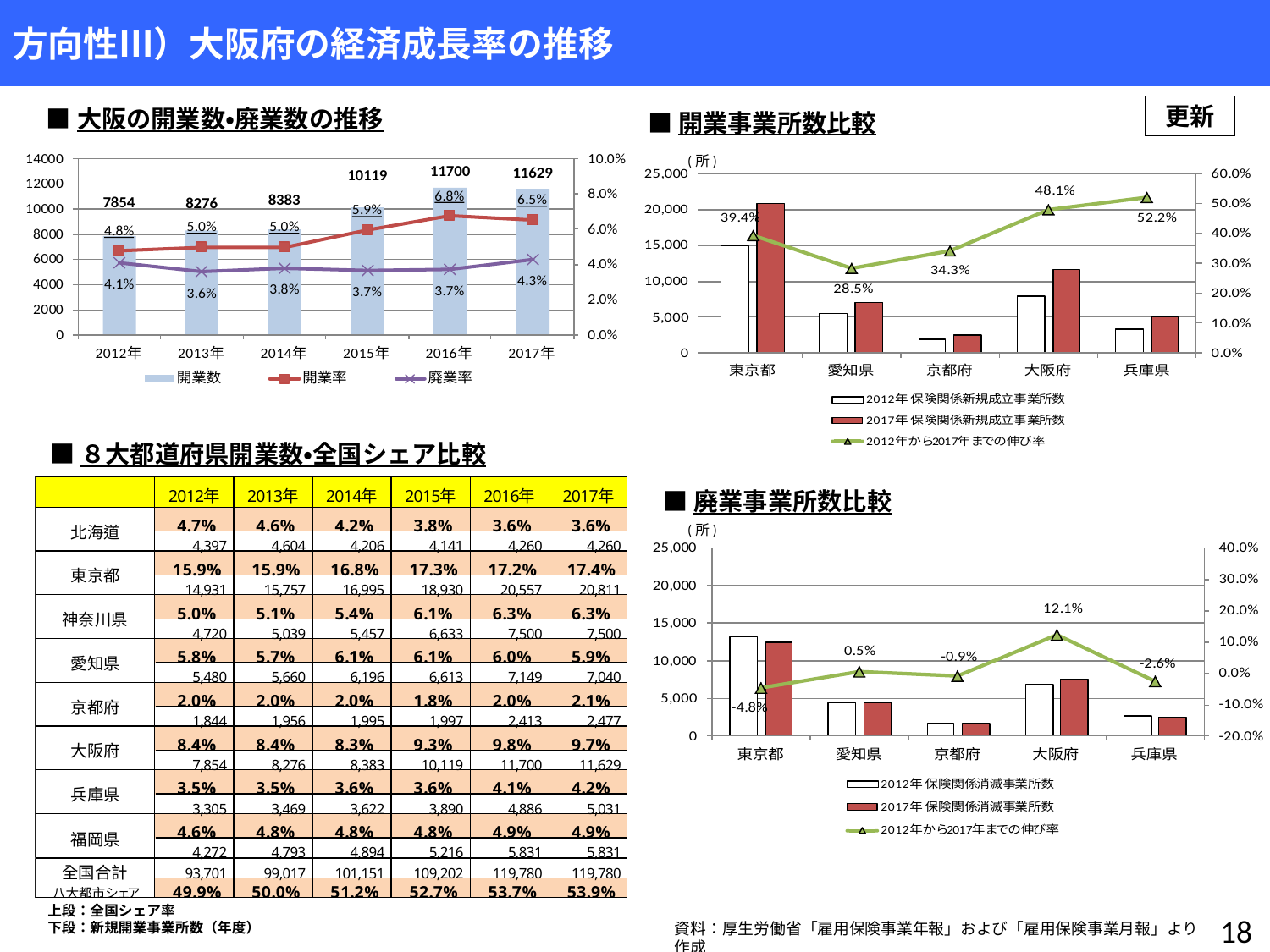
In the chart titled 大阪の開業数•廃業数の推移, how many series does the legend list? 3 In the chart titled 大阪の開業数•廃業数の推移, what is the 開業数 value for 2016年? 11700 In the chart titled 開業事業所数比較, is the 2017年 保険関係新規成立事業所数 bar for 東京都 greater or less than 20,000? greater In the chart titled 大阪の開業数•廃業数の推移, does the 開業率 generally rise or fall from 2012年 to 2016年? rise In the chart titled 開業事業所数比較, what is the 2012年から2017年までの伸び率 for 大阪府? 48.1% In the chart titled 大阪の開業数•廃業数の推移, what is the 開業率 for 2015年? 5.9% In the chart titled 開業事業所数比較, which prefecture has the highest 2012年から2017年までの伸び率? 兵庫県 In the chart titled 大阪の開業数•廃業数の推移, which year has the lowest 廃業率? 2013年 In the chart titled 大阪の開業数•廃業数の推移, what is the difference between the 開業数 for 2017年 and 2012年? 3775 In the chart titled 廃業事業所数比較, which prefecture has the lowest 2012年から2017年までの伸び率? 東京都 In the chart titled 開業事業所数比較, how many prefectures are shown on the x axis? 5 In the chart titled 廃業事業所数比較, what is the 2012年から2017年までの伸び率 for 大阪府? 12.1%